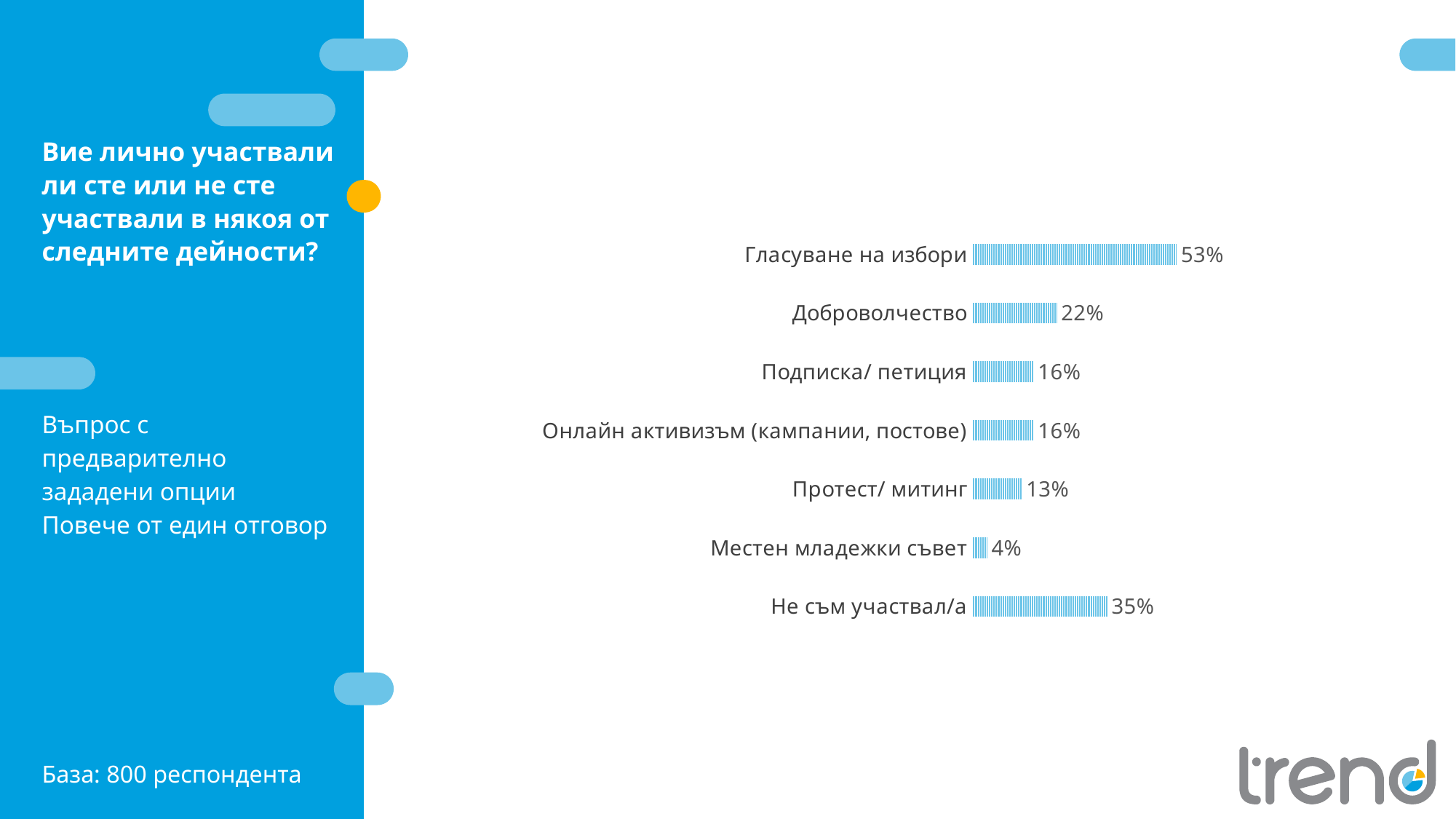
How many categories are shown in the chart? 7 What is the value for Не съм участвал/а? 35% What is the value for Доброволчество? 22% What is the difference between Доброволчество and Местен младежки съвет? 18% What is the difference between Гласуване на избори and Не съм участвал/а? 18% What kind of chart is shown on the slide? Bar chart Which two categories share the same value of 16%? Подписка/ петиция and Онлайн активизъм (кампании, постове) What is the value for Протест/ митинг? 13% Which activity has the highest percentage? Гласуване на избори Which category has the lowest percentage? Местен младежки съвет Which is larger, Доброволчество or Протест/ митинг? Доброволчество What percentage of respondents reported voting in elections (Гласуване на избори)? 53%